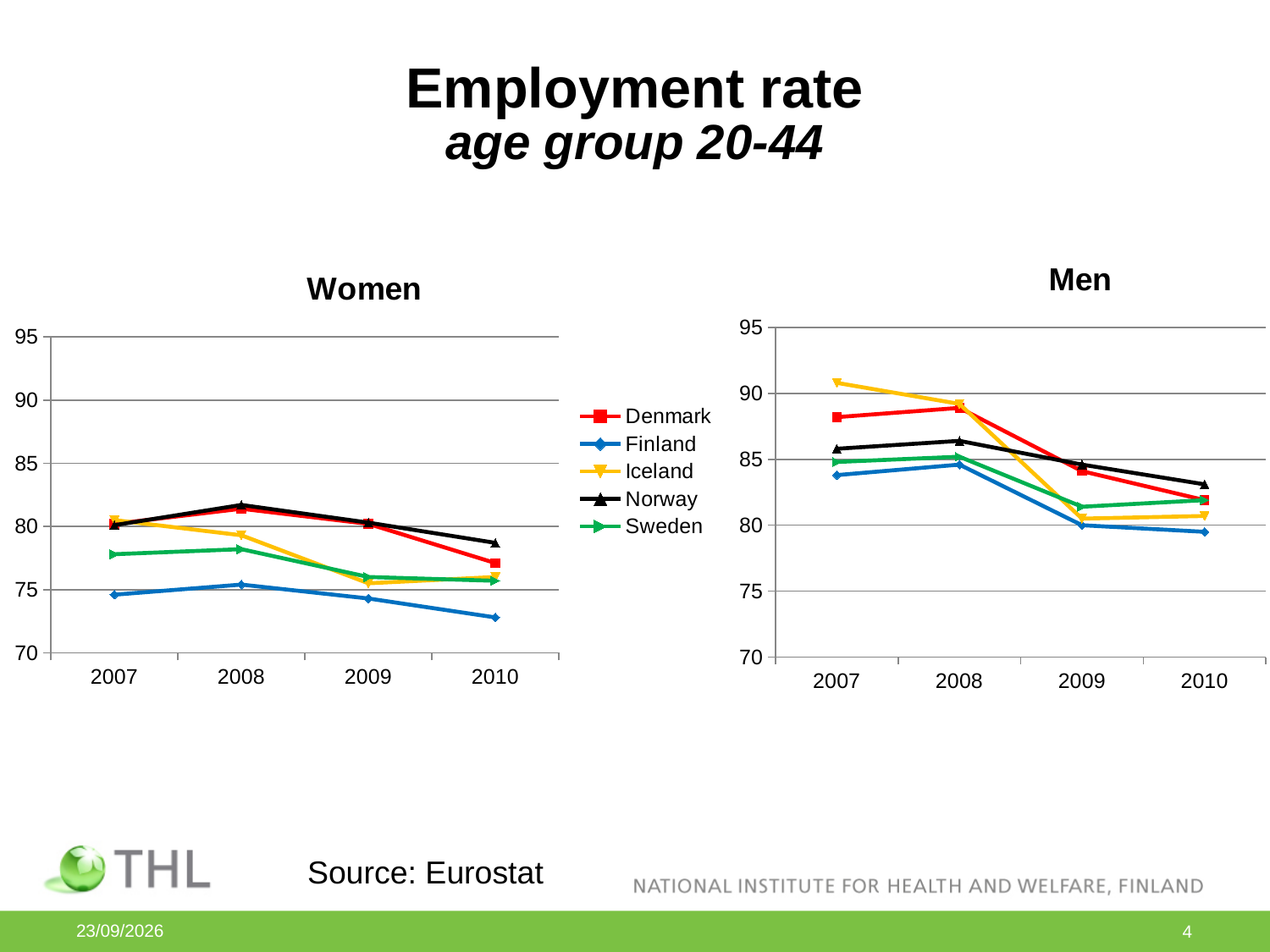
In the Men chart, how many years are plotted along the x axis? 4 In the Men chart, is the value for Norway in 2010 greater or less than 85? less What kind of chart is the Women chart? line chart In the Men chart, which country has the highest employment rate in 2007? Iceland How many series does the legend list? 5 In the Women chart, is the value for Finland in 2010 greater or less than 75? less In the Women chart, is the value for Sweden in 2007 greater or less than 80? less What is the title of the chart on the right? Men In the Women chart, which country has the lowest employment rate in 2010? Finland In the Men chart, does the value for Iceland rise or fall from 2007 to 2010? fall In the Men chart, which is larger in 2010, Norway or Finland? Norway